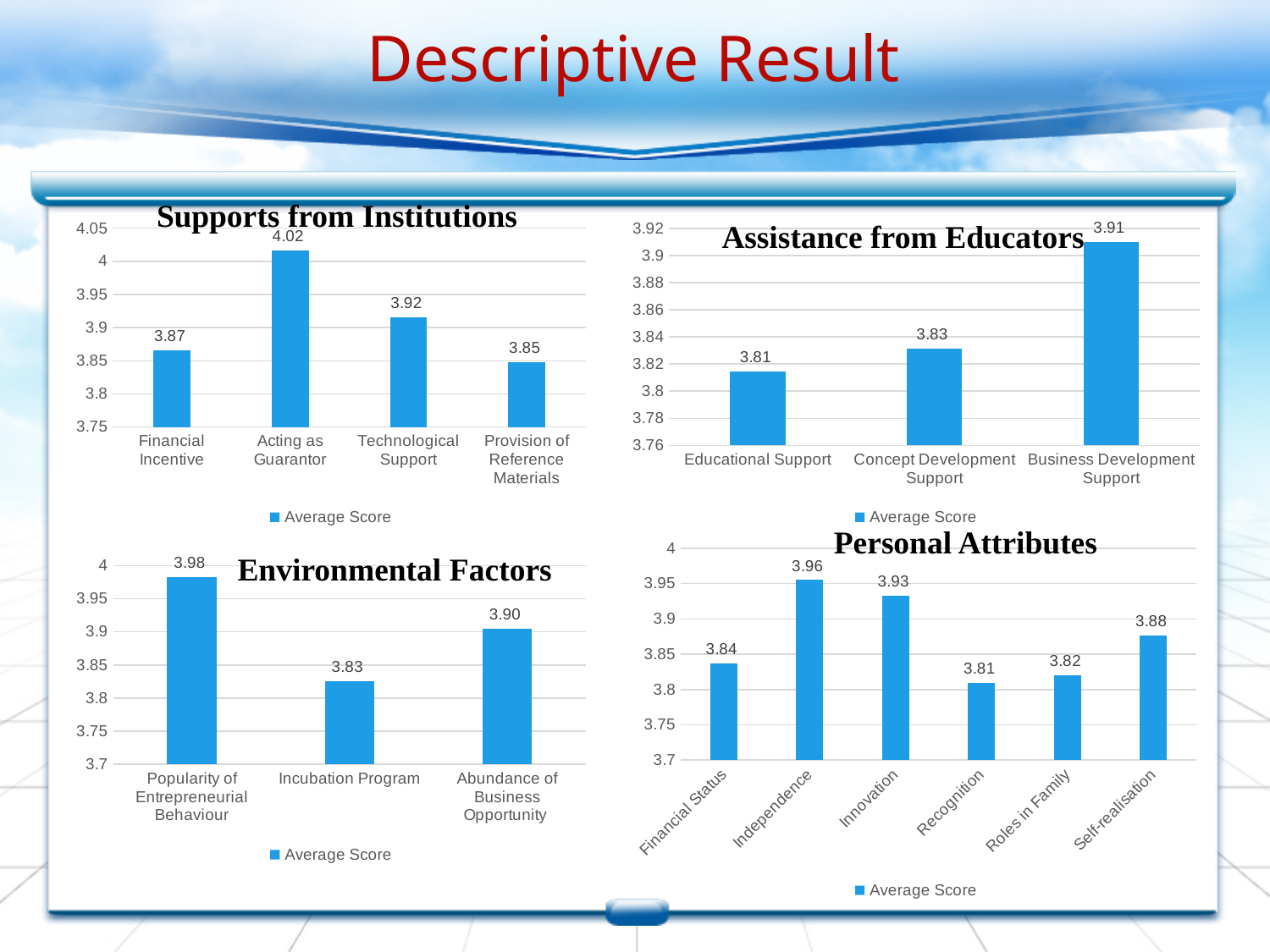
In the 'Assistance from Educators' chart, which category has the highest average score? Business Development Support In the 'Assistance from Educators' chart, what is the difference between the scores for Business Development Support and Educational Support? 0.10 In the 'Personal Attributes' chart, which category has the highest average score? Independence In the 'Environmental Factors' chart, how many categories are shown? 3 In the 'Personal Attributes' chart, which is larger, the score for Innovation or the score for Recognition? Innovation In the 'Supports from Institutions' chart, which category has the lowest average score? Provision of Reference Materials In the 'Personal Attributes' chart, how many categories are shown? 6 In the 'Supports from Institutions' chart, what is the average score for Acting as Guarantor? 4.02 In the 'Assistance from Educators' chart, what is the average score for Concept Development Support? 3.83 In the 'Personal Attributes' chart, what is the average score for Self-realisation? 3.88 What type of chart is the 'Supports from Institutions' chart? Bar chart In the 'Environmental Factors' chart, what is the average score for Incubation Program? 3.83